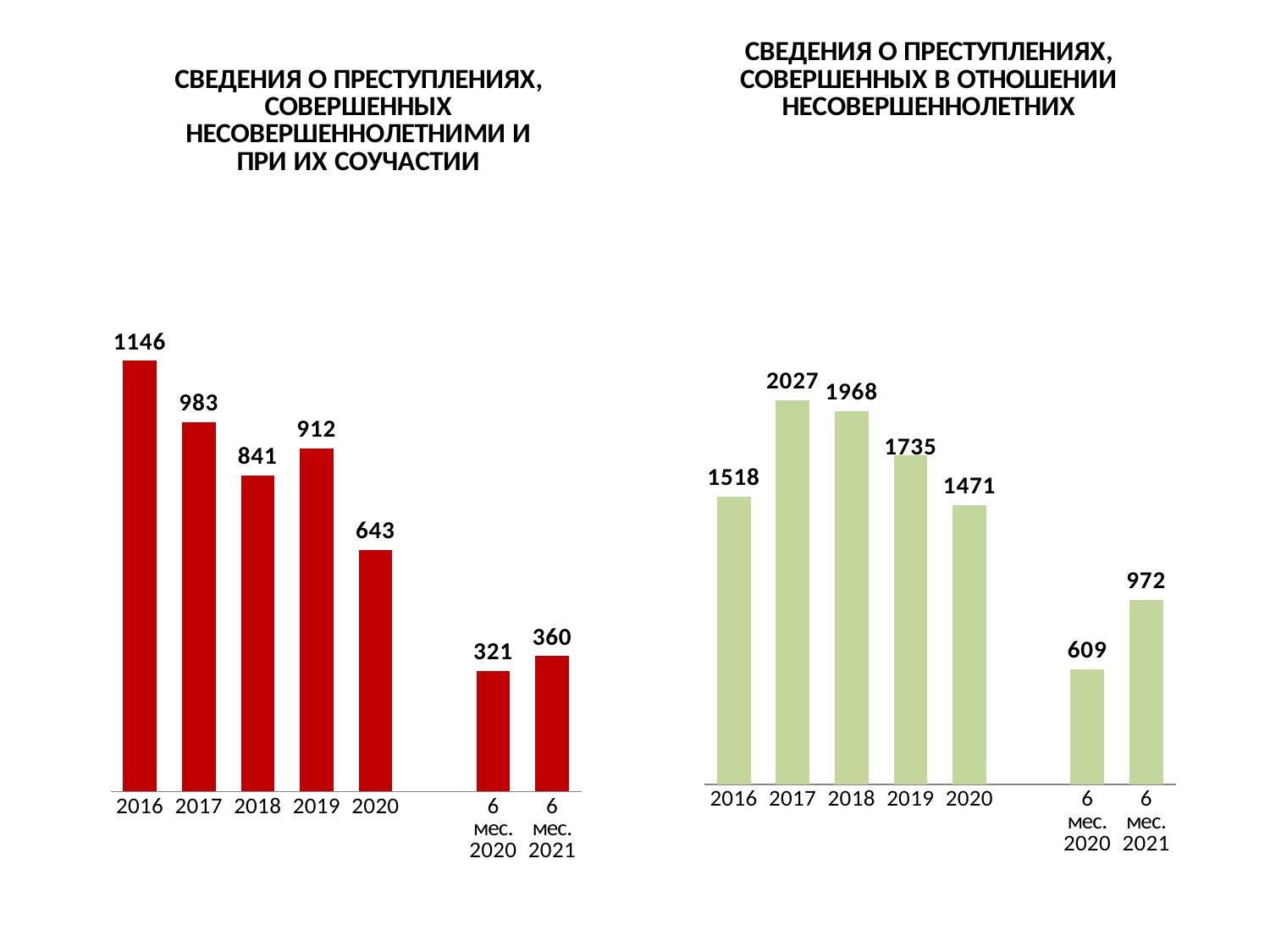
In the right chart, which is larger: the value for 2016 or the value for 2020? 2016 What type of chart is shown on the right side of the slide? Bar chart In the left chart, do the values rise or fall from 2016 to 2020? Fall What colour are the bars in the right chart? Light green In the right chart (crimes committed against minors), what is the value for 2019? 1735 In the left chart, what is the difference between the values for 2016 and 2020? 503 How many bars are plotted in the left chart? 7 In the left chart, which is larger: the value for 2018 or the value for 2019? 2019 In the left chart (crimes committed by minors), what is the value for 2016? 1146 In the right chart, which category has the highest value? 2017 In the left chart, which category has the lowest value? 6 мес. 2020 In the right chart, what is the difference between the values for 6 мес. 2021 and 6 мес. 2020? 363